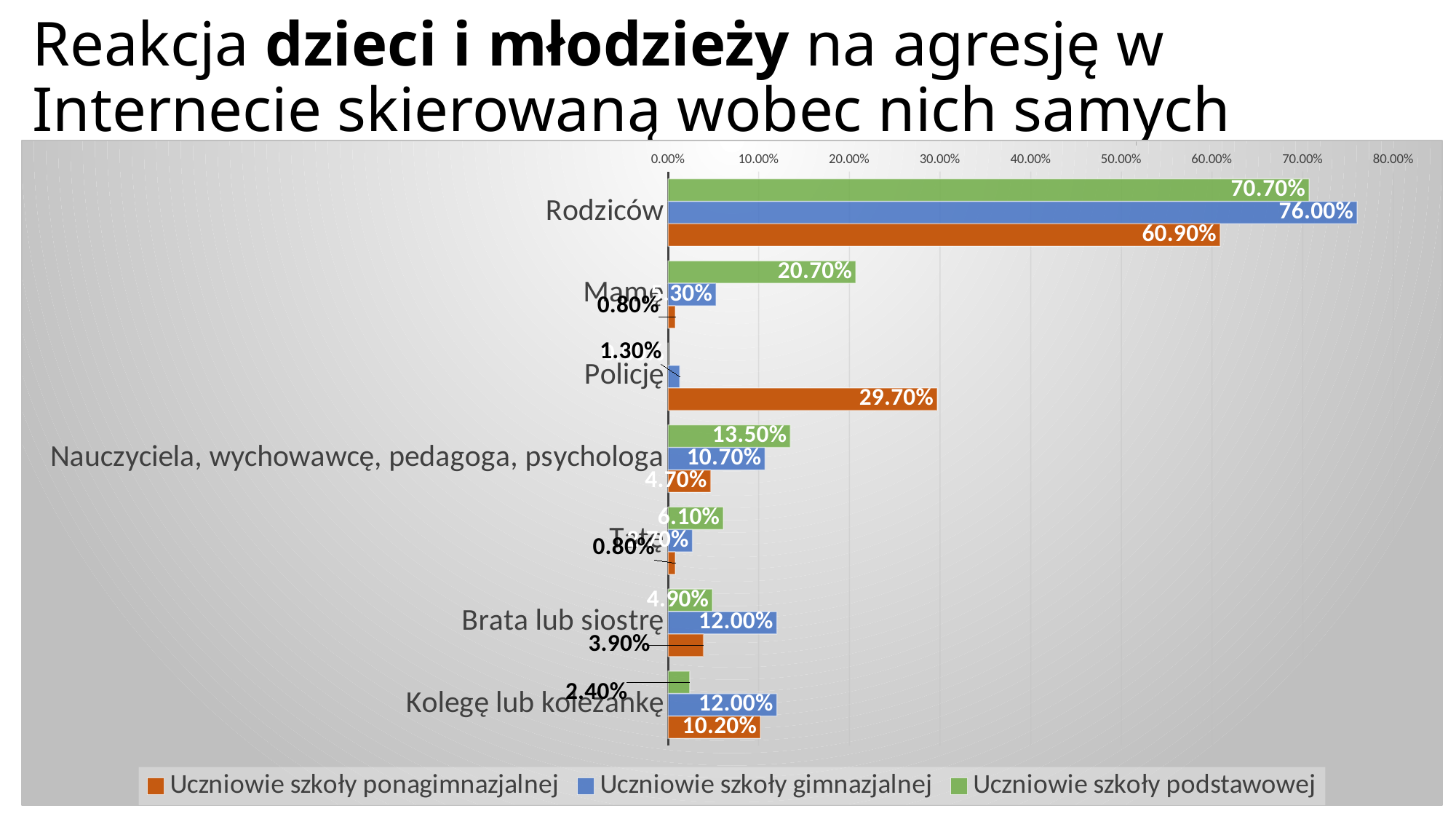
Is the Uczniowie szkoły ponagimnazjalnej value for Policję greater or less than 20.00%? greater Which category has the highest value in the Uczniowie szkoły ponagimnazjalnej series? Rodziców What is the value for Policję in the Uczniowie szkoły ponagimnazjalnej series? 29.70% What is the value for Kolegę lub koleżankę in the Uczniowie szkoły ponagimnazjalnej series? 10.20% What is the value for Rodziców in the Uczniowie szkoły gimnazjalnej series? 76.00% For Rodziców, which series has the larger value: Uczniowie szkoły podstawowej or Uczniowie szkoły gimnazjalnej? Uczniowie szkoły gimnazjalnej How many categories are shown on the chart? 7 Which category has the highest value in the Uczniowie szkoły podstawowej series? Rodziców What is the value for Mamę in the Uczniowie szkoły podstawowej series? 20.70% What is the difference between the Uczniowie szkoły gimnazjalnej and Uczniowie szkoły ponagimnazjalnej values for Rodziców? 15.10% What is the difference between the Uczniowie szkoły podstawowej and Uczniowie szkoły gimnazjalnej values for Nauczyciela, wychowawcę, pedagoga, psychologa? 2.80% How many series does the legend list? 3